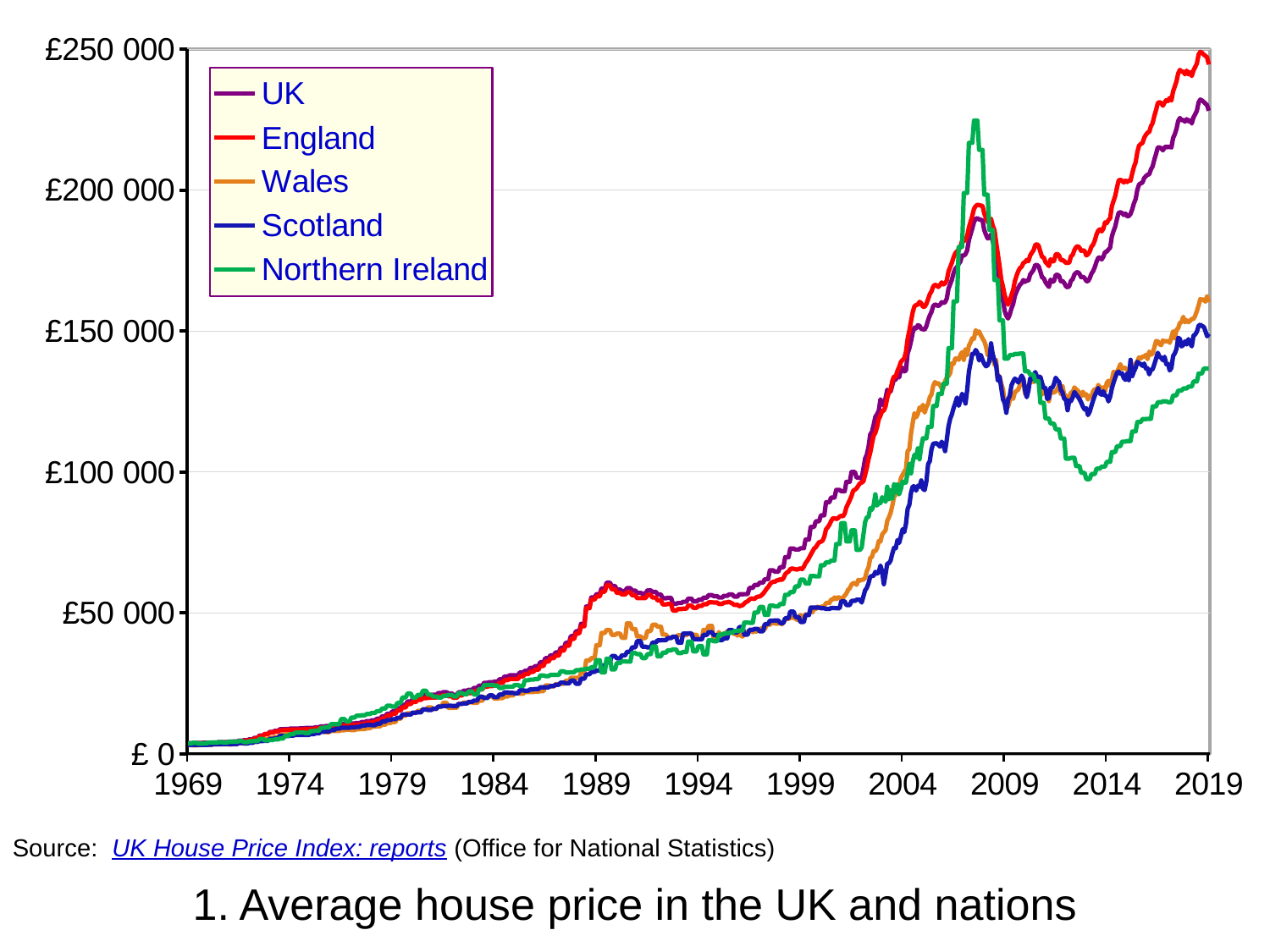
Is the value for England in 2019 greater or less than £200 000? greater Is the value for Northern Ireland in 2019 greater or less than £150 000? less What is the title of the chart? 1. Average house price in the UK and nations At 2019, which is larger: the value for Wales or the value for Scotland? Wales Is the peak value of the Northern Ireland line, around 2008, greater or less than £200 000? greater Which series has the highest value at 2019? England Which series has the lowest value at 2019? Northern Ireland How many series does the legend list? 5 Overall, do the house price lines rise or fall from 1969 to 2019? Rise What kind of chart is shown on the slide? Line chart Which colour is used for the Northern Ireland line? Green